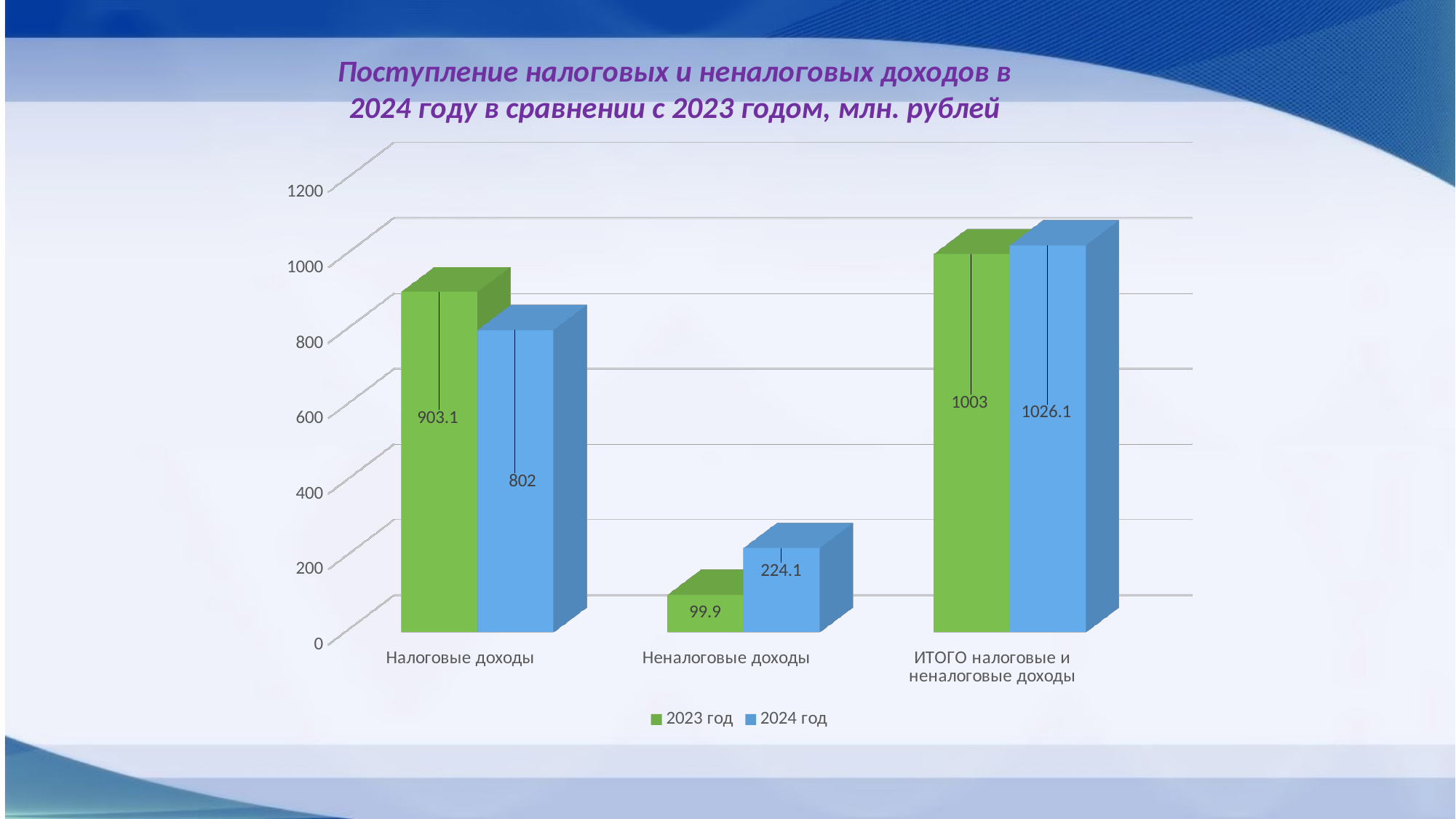
How many series does the legend list? 2 What kind of chart is shown on the slide? Bar chart Which colour represents the 2024 год series? Blue What is the value for Неналоговые доходы in the 2024 год series? 224.1 What is the value for ИТОГО налоговые и неналоговые доходы in the 2023 год series? 1003 What is the value for Налоговые доходы in the 2024 год series? 802 Which is larger for Налоговые доходы: the 2023 год value or the 2024 год value? 2023 год What is the value for Налоговые доходы in the 2023 год series? 903.1 How many categories are shown on the x axis? 3 What is the difference between the 2024 год and 2023 год values for Неналоговые доходы? 124.2 Which category has the highest value in the 2024 год series? ИТОГО налоговые и неналоговые доходы Which category has the lowest value in the 2023 год series? Неналоговые доходы